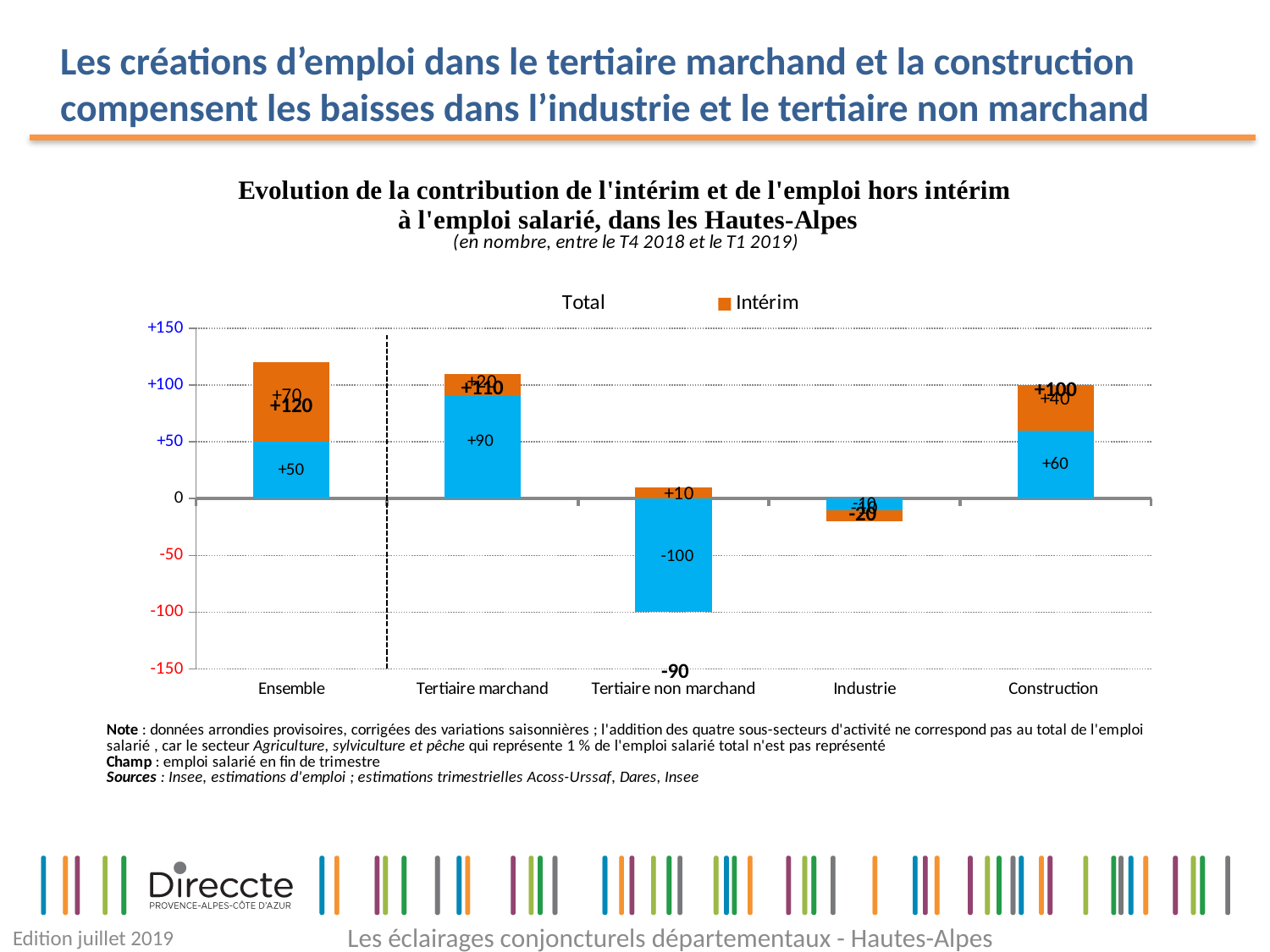
What is the Intérim value for Ensemble? +70 What is the Intérim value for Construction? +40 What is the total value shown for Ensemble? +120 What is the value of the blue (hors intérim) segment for Tertiaire marchand? +90 What is the total value shown for Tertiaire non marchand? -90 How many categories are shown along the x axis of the chart? 5 What kind of chart is shown on the slide? Stacked bar chart What is the difference between the Intérim value for Ensemble and the Intérim value for Construction? 30 Which category has the highest total value? Ensemble Which category has the lowest total value? Tertiaire non marchand Which has the larger Intérim value, Tertiaire marchand or Construction? Construction What is the value of the blue (hors intérim) segment for Tertiaire non marchand? -100